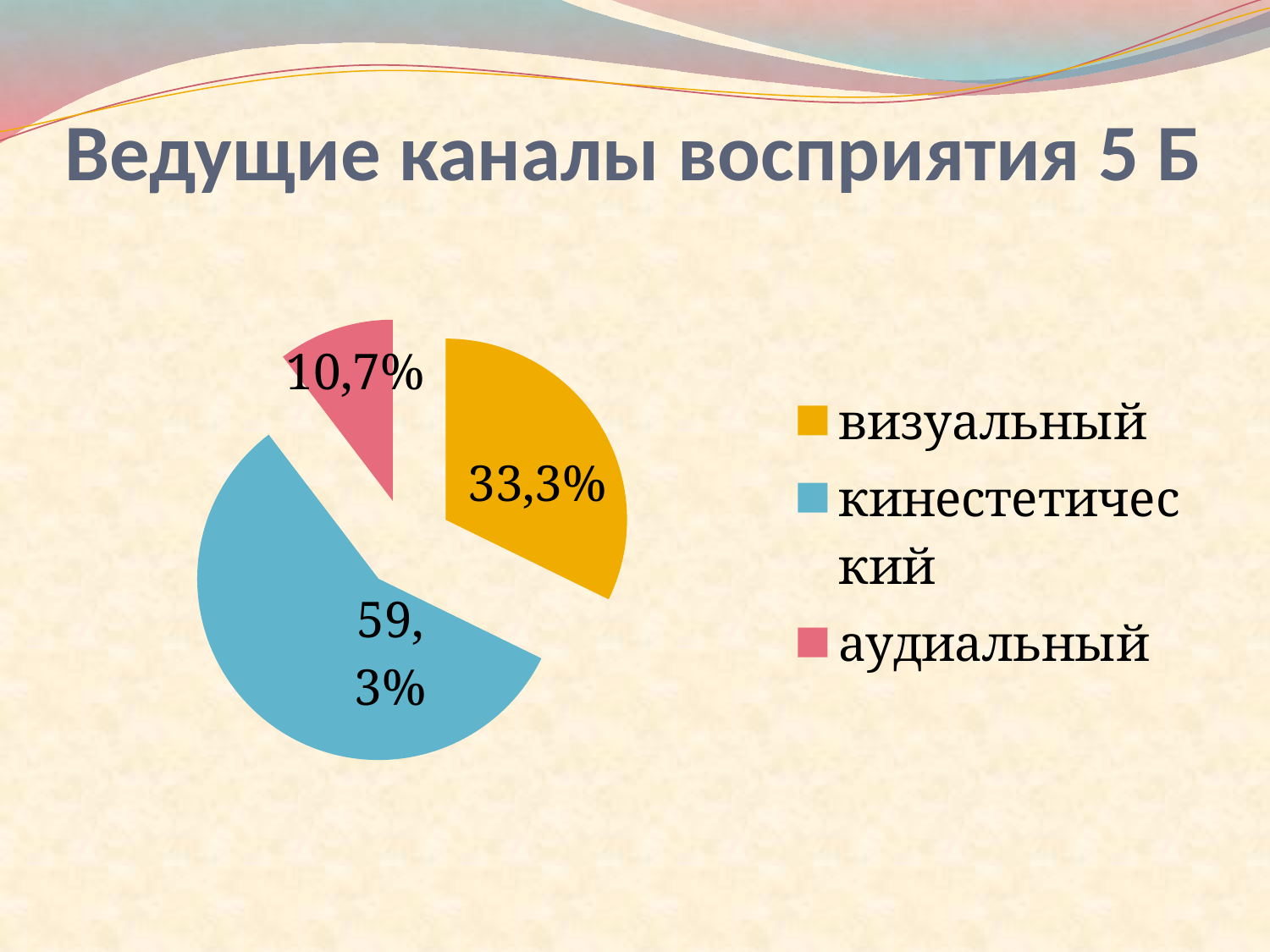
What is the value for аудиальный? 10,7% What is the value for кинестетический? 59,3% What is the difference between визуальный and аудиальный? 22,6% What type of chart is shown on the slide? pie chart What is the difference between кинестетический and визуальный? 26,0% How many slices does the pie chart have? 3 Which is larger, визуальный or аудиальный? визуальный Which category has the smallest slice? аудиальный What is the title of the chart? Ведущие каналы восприятия 5 Б Which category has the largest slice? кинестетический What colour is the slice for аудиальный? pink What is the value for визуальный? 33,3%